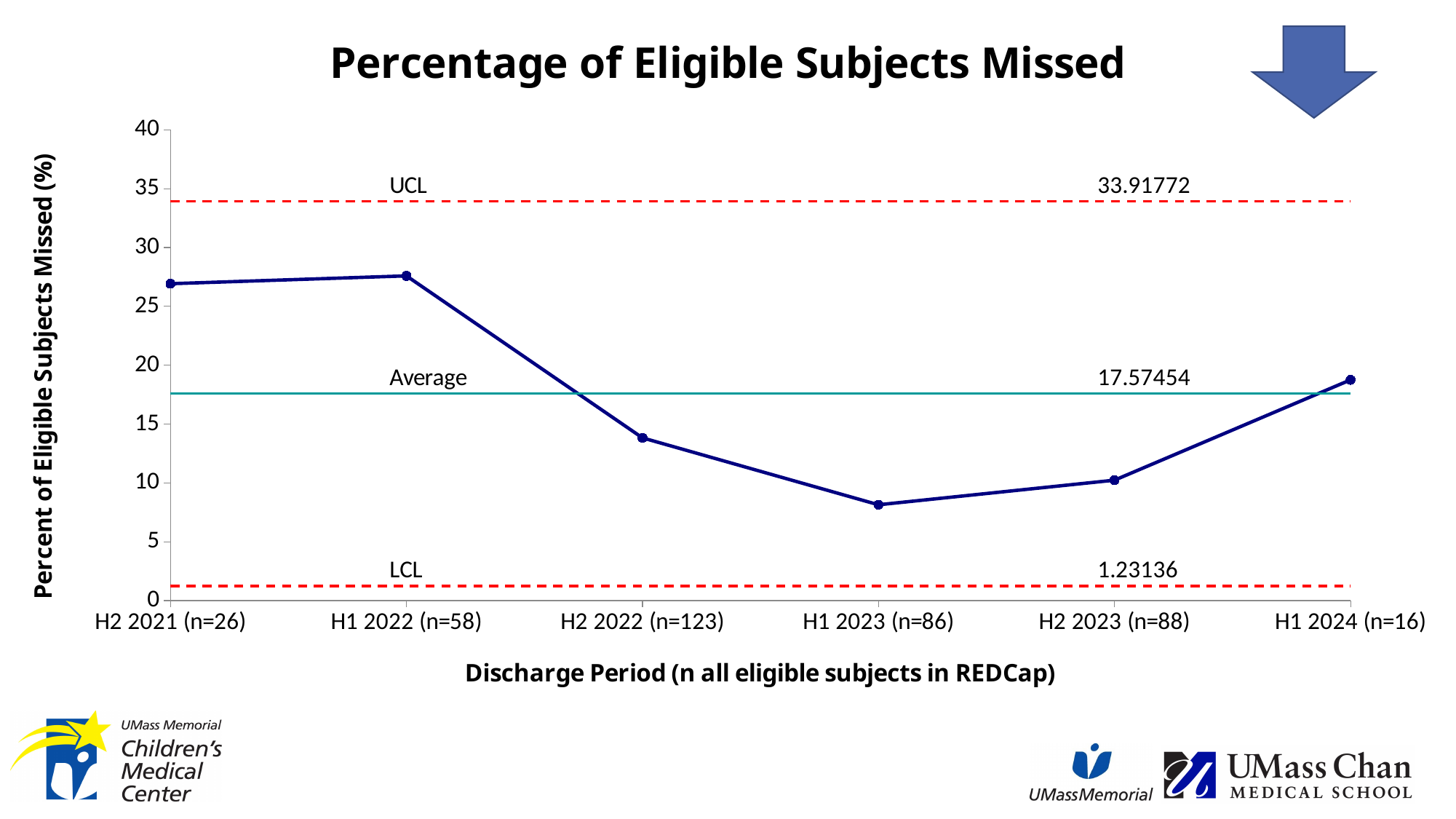
What is the title of the chart? Percentage of Eligible Subjects Missed Which is larger, the value for H2 2022 (n=123) or the value for H1 2023 (n=86)? H2 2022 (n=123) Which discharge period has the lowest percentage of eligible subjects missed? H1 2023 (n=86) What is the value of the Average line? 17.57454 Is the value for H1 2023 (n=86) greater or less than 10? less Is the value for H1 2024 (n=16) greater or less than 15? greater Do the values rise or fall from H1 2022 (n=58) to H1 2023 (n=86)? fall What is the value of the LCL line? 1.23136 How many discharge periods are plotted on the x axis? 6 Is the value for H2 2021 (n=26) greater or less than 25? greater What kind of chart is shown on the slide? line chart What is the value of the UCL line? 33.91772